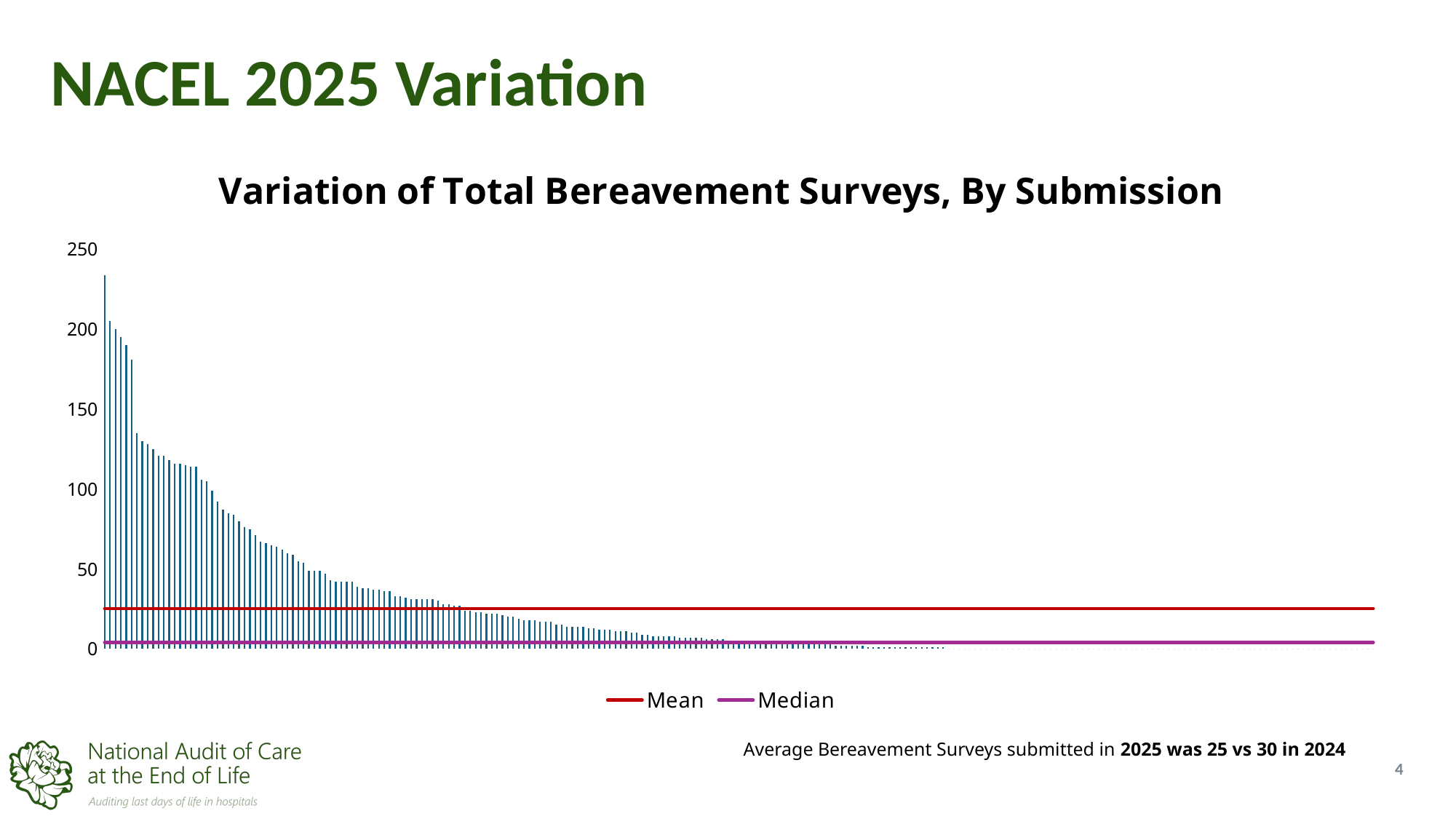
According to the slide, what was the average number of Bereavement Surveys submitted in 2025? 25 Is the value of the tallest bar greater or less than 200? greater What kind of chart is shown on the slide? bar chart How many series does the chart's legend list? 2 Is the Median line greater or less than 50? less What is the title of the chart? Variation of Total Bereavement Surveys, By Submission According to the slide, what was the average number of Bereavement Surveys submitted in 2024? 30 Which two entries appear in the chart's legend? Mean and Median Do the bar values rise or fall moving from left to right along the x axis? fall What is the highest value shown on the chart's y axis? 250 Which is higher on the chart, the Mean line or the Median line? Mean Is the Mean line greater or less than 50? less